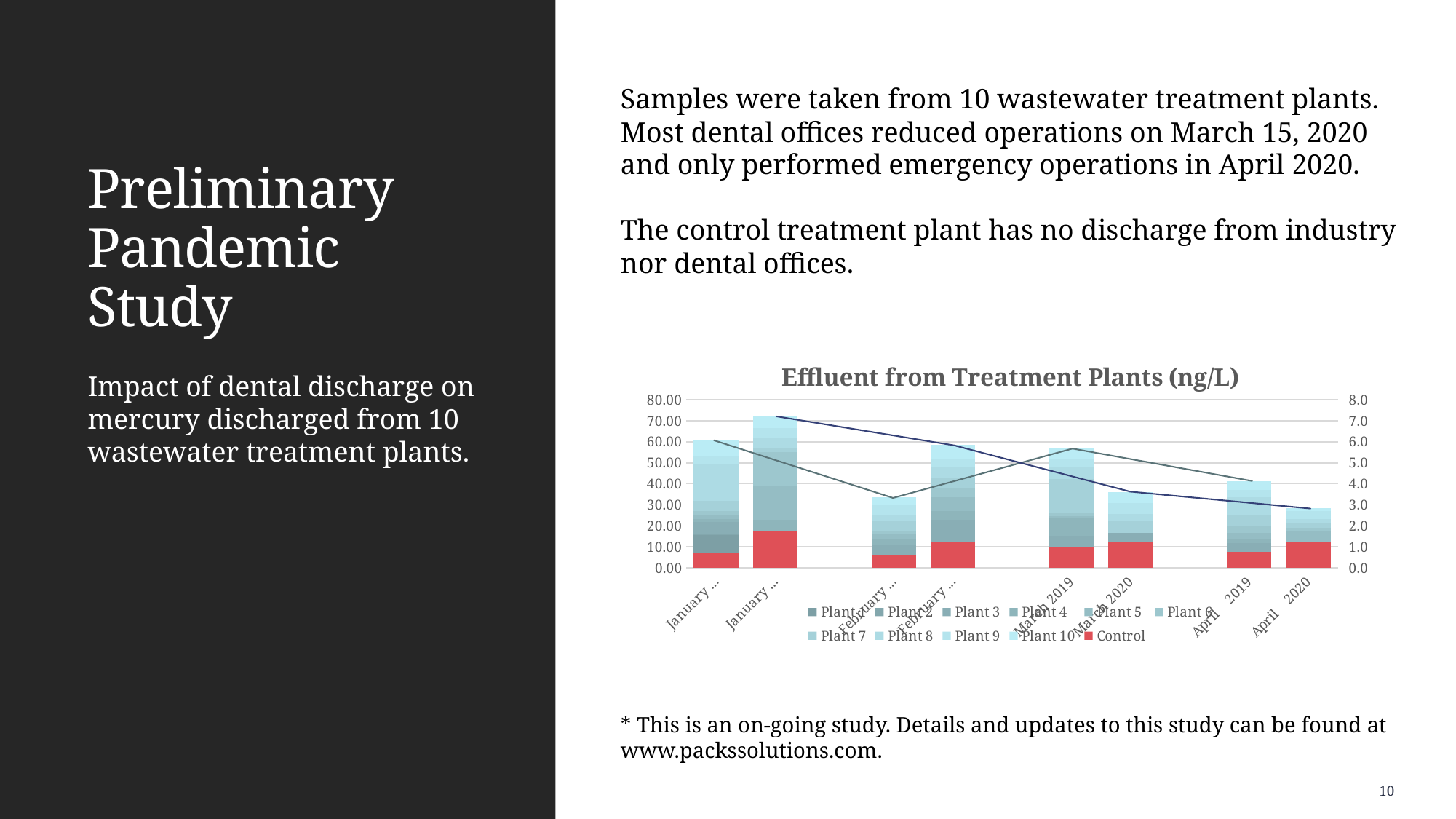
What kind of chart is shown on the slide? Stacked bar chart with lines Is the total stacked value for March 2019 greater or less than 50? greater Is the Control value for April 2019 greater or less than 10? less Is the total stacked value for March 2020 greater or less than 40? less How many series does the chart legend list? 11 Which colour represents the Control series in the legend? Red What is the title of the chart? Effluent from Treatment Plants (ng/L) Which has the larger total stacked value, March 2019 or March 2020? March 2019 Which has the larger total stacked value, April 2019 or April 2020? April 2019 How many bars are plotted in the chart? 8